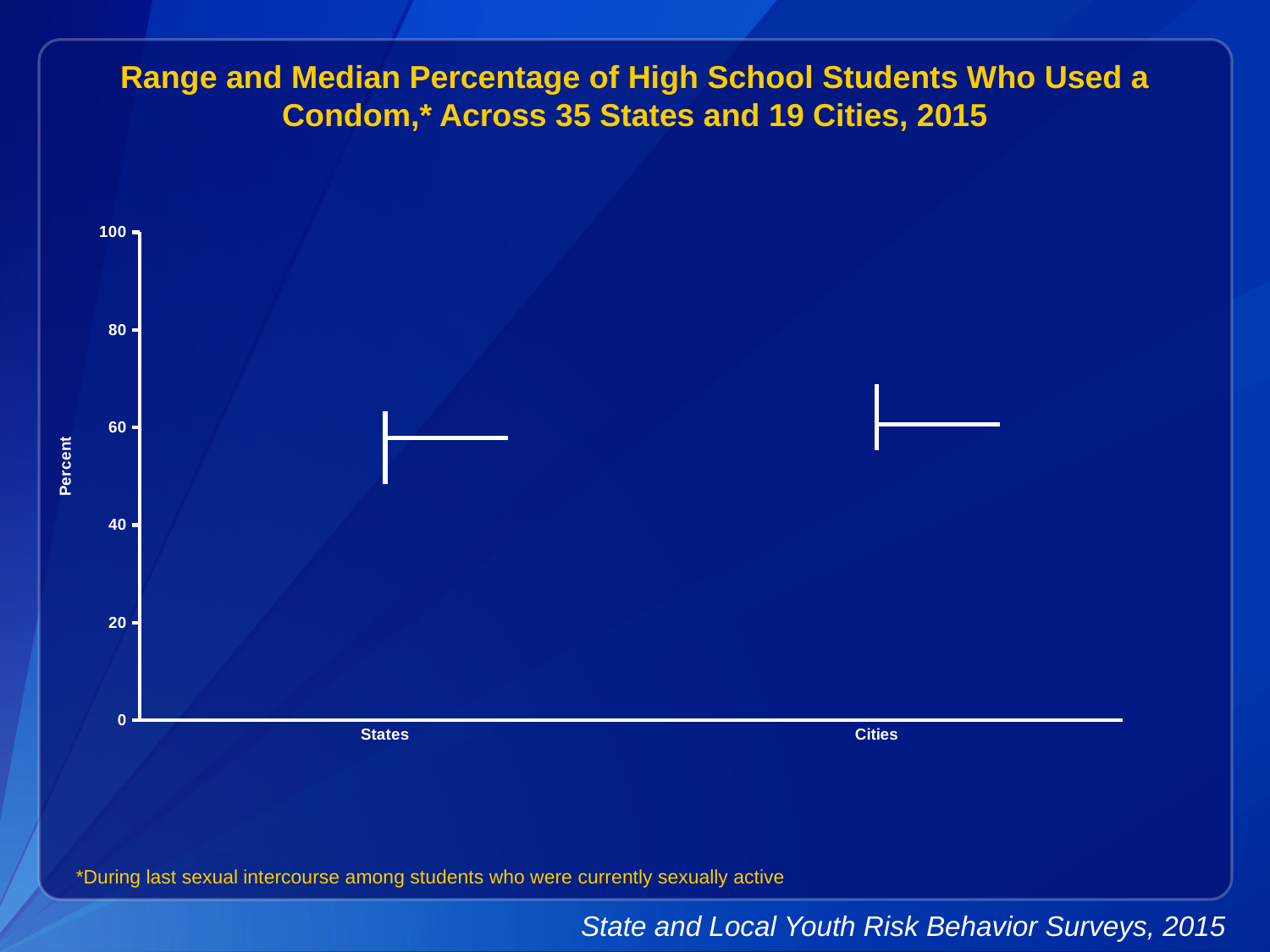
Is the top of the range for Cities greater or less than 60? greater Which has the higher median percentage, States or Cities? Cities Which category has the higher top of its range, States or Cities? Cities Is the top of the range for States greater or less than 80? less How many categories are plotted on the x axis? 2 What is the label on the y axis of the chart? Percent Is the bottom of the range for States greater or less than 60? less What are the two categories shown on the x axis of the chart? States and Cities What is the highest value shown on the y axis? 100